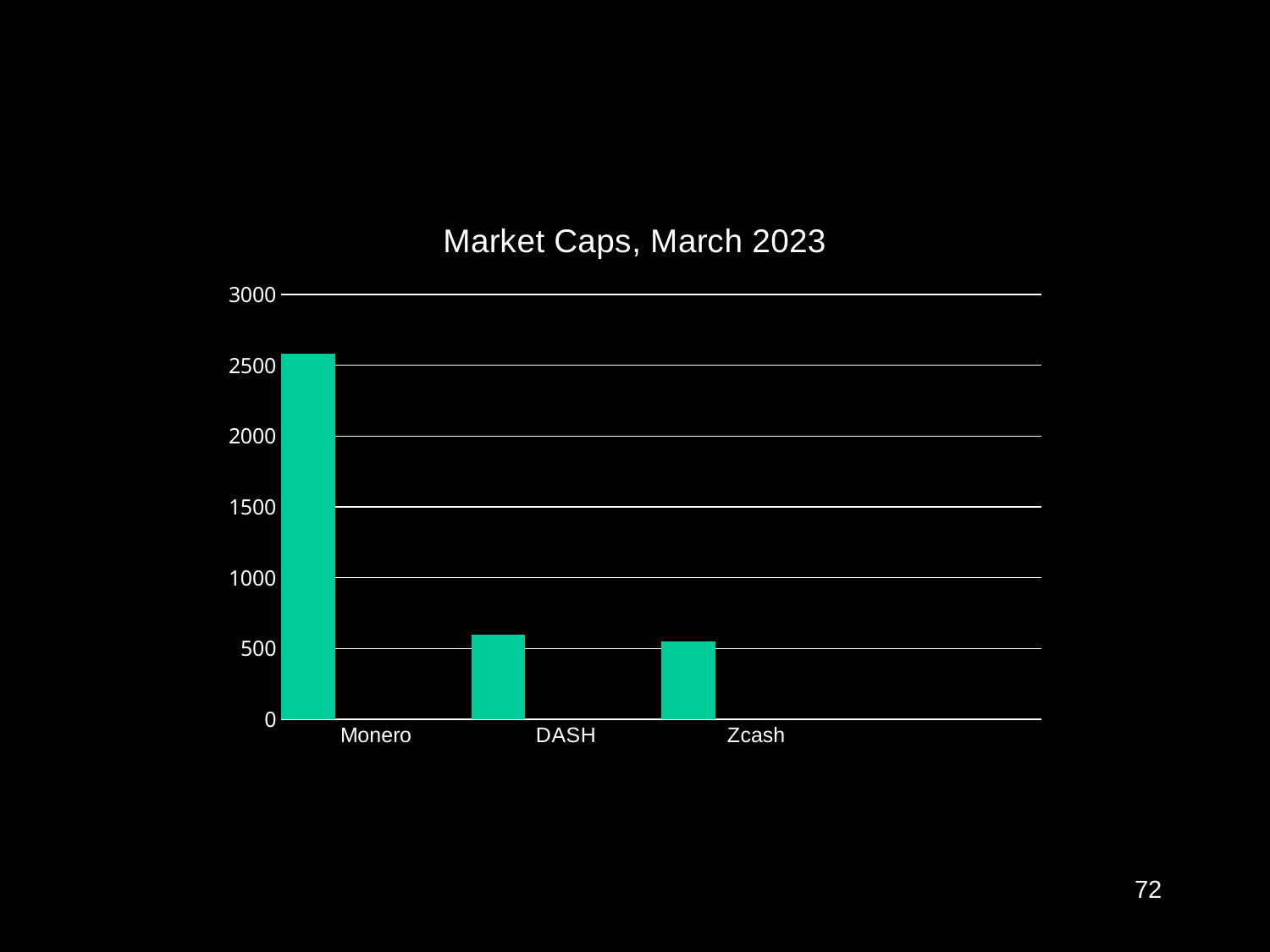
Is the value for Zcash greater or less than 1000? less Which is larger, the value for Monero or the value for Zcash? Monero How many categories are plotted in the chart? 3 Is the value for DASH greater or less than 1000? less Do the values rise or fall from left to right along the x axis? Fall Which is larger, the value for Monero or the value for DASH? Monero What kind of chart is shown on the slide? Bar chart Which category has the highest value? Monero Is the value for Monero greater or less than 2000? greater What is the highest value shown on the vertical axis? 3000 What is the title of the chart? Market Caps, March 2023